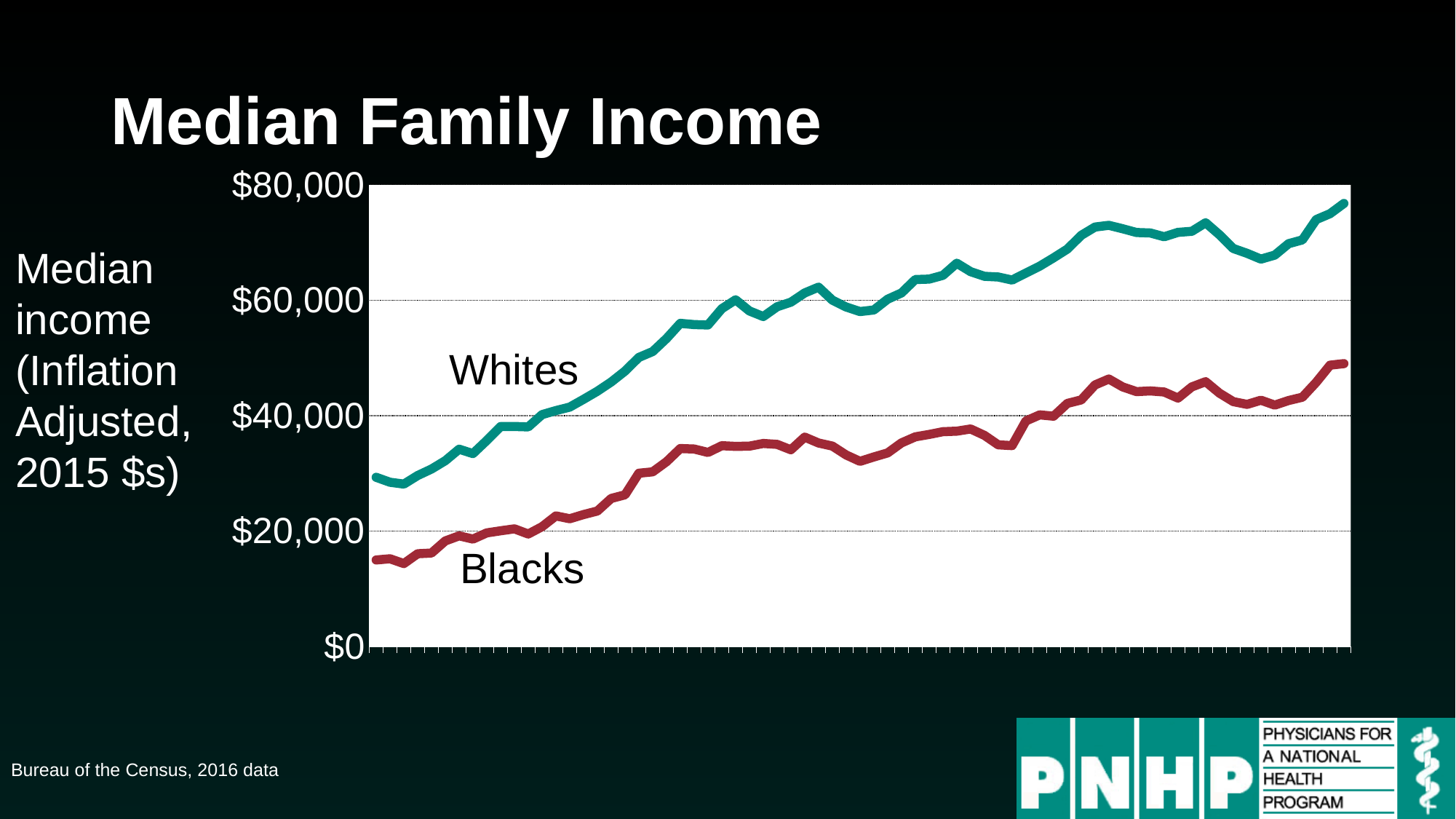
Does the Blacks series ever reach $60,000 on the chart? No What is the title of the chart on the slide? Median Family Income What kind of chart is shown on the slide? line chart Does the Blacks series generally rise or fall from left to right across the chart? rise Which series is higher throughout the chart, Whites or Blacks? Whites How many data series are plotted on the chart? 2 Is the value for Blacks at the right end of the chart greater or less than $40,000? greater What is the highest value shown on the vertical axis of the chart? $80,000 Is the value for Blacks at the left end of the chart greater or less than $20,000? less Does the Whites series generally rise or fall from left to right across the chart? rise